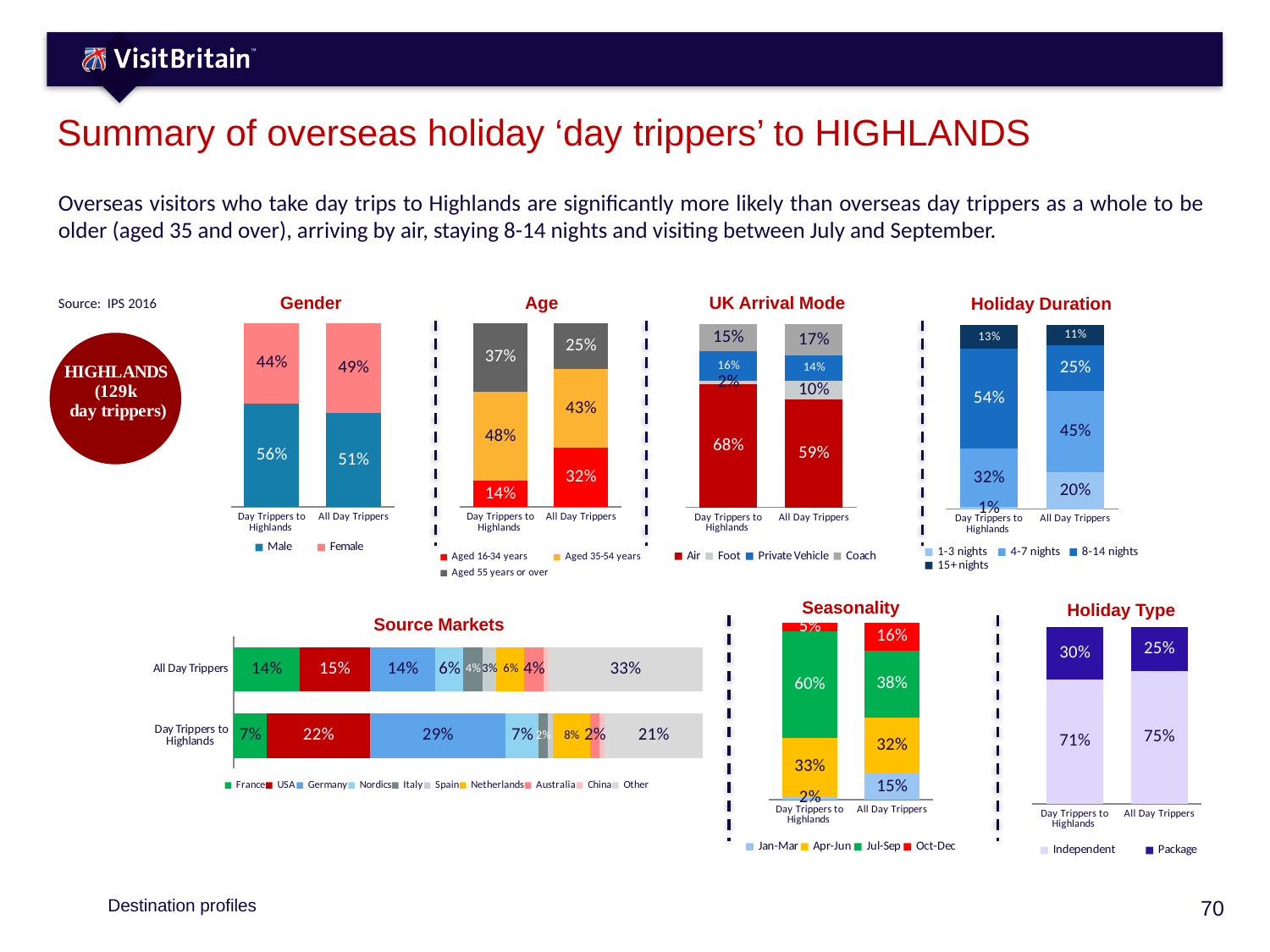
How many series does the legend of the Source Markets chart list? 10 In the Age chart, what percentage of Day Trippers to Highlands are Aged 35-54 years? 48% In the UK Arrival Mode chart, what is the Air share for All Day Trippers? 59% In the Age chart, what is the difference between the Aged 16-34 years share for All Day Trippers and for Day Trippers to Highlands? 18% In the Source Markets chart, which source market has the largest share among Day Trippers to Highlands (excluding Other)? Germany What kind of chart is the Source Markets chart? Stacked horizontal bar chart In the Gender chart, what percentage of Day Trippers to Highlands are Male? 56% How many series does the legend of the UK Arrival Mode chart list? 4 In the Holiday Type chart, which group has the larger Package share, Day Trippers to Highlands or All Day Trippers? Day Trippers to Highlands In the Seasonality chart, which season has the smallest share for Day Trippers to Highlands? Jan-Mar In the Seasonality chart, what is the Jul-Sep share for Day Trippers to Highlands? 60% In the Holiday Duration chart, what percentage of Day Trippers to Highlands stay 8-14 nights? 54%